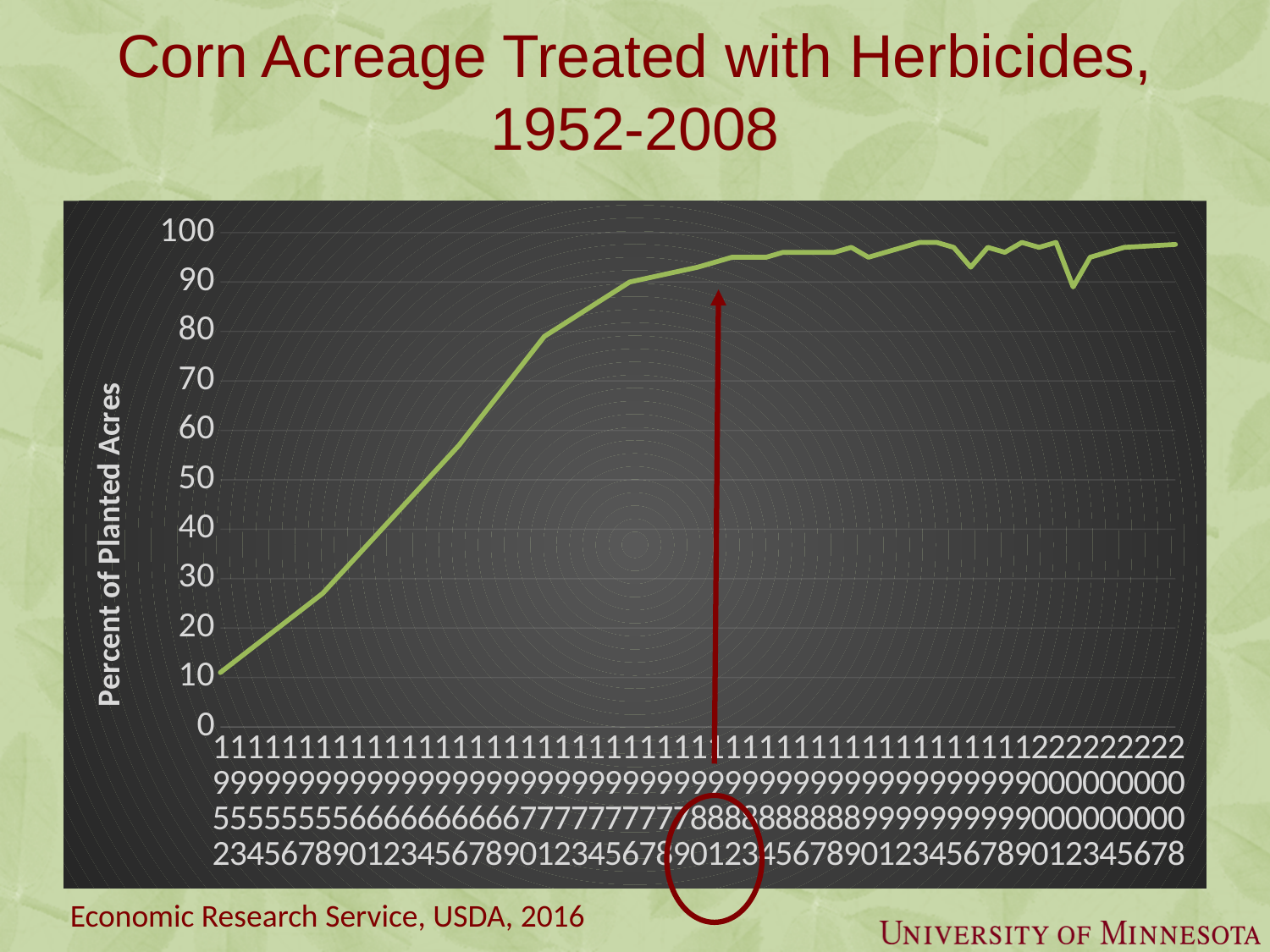
Is the value for 1980 greater or less than 80? greater Which year has the lowest percent of planted acres treated with herbicides? 1952 Is the value for 1960 greater or less than 40? less What is the label on the vertical axis of the chart? Percent of Planted Acres Which year has the larger value, 1960 or 1970? 1970 What kind of chart is shown on the slide? line chart Which year has the larger value, 1952 or 2008? 2008 What is the highest value shown on the vertical axis? 100 Is the value for 2008 greater or less than 90? greater Does the percent of planted acres treated with herbicides generally rise or fall from 1952 to 2008? rise What is the title of the chart? Corn Acreage Treated with Herbicides, 1952-2008